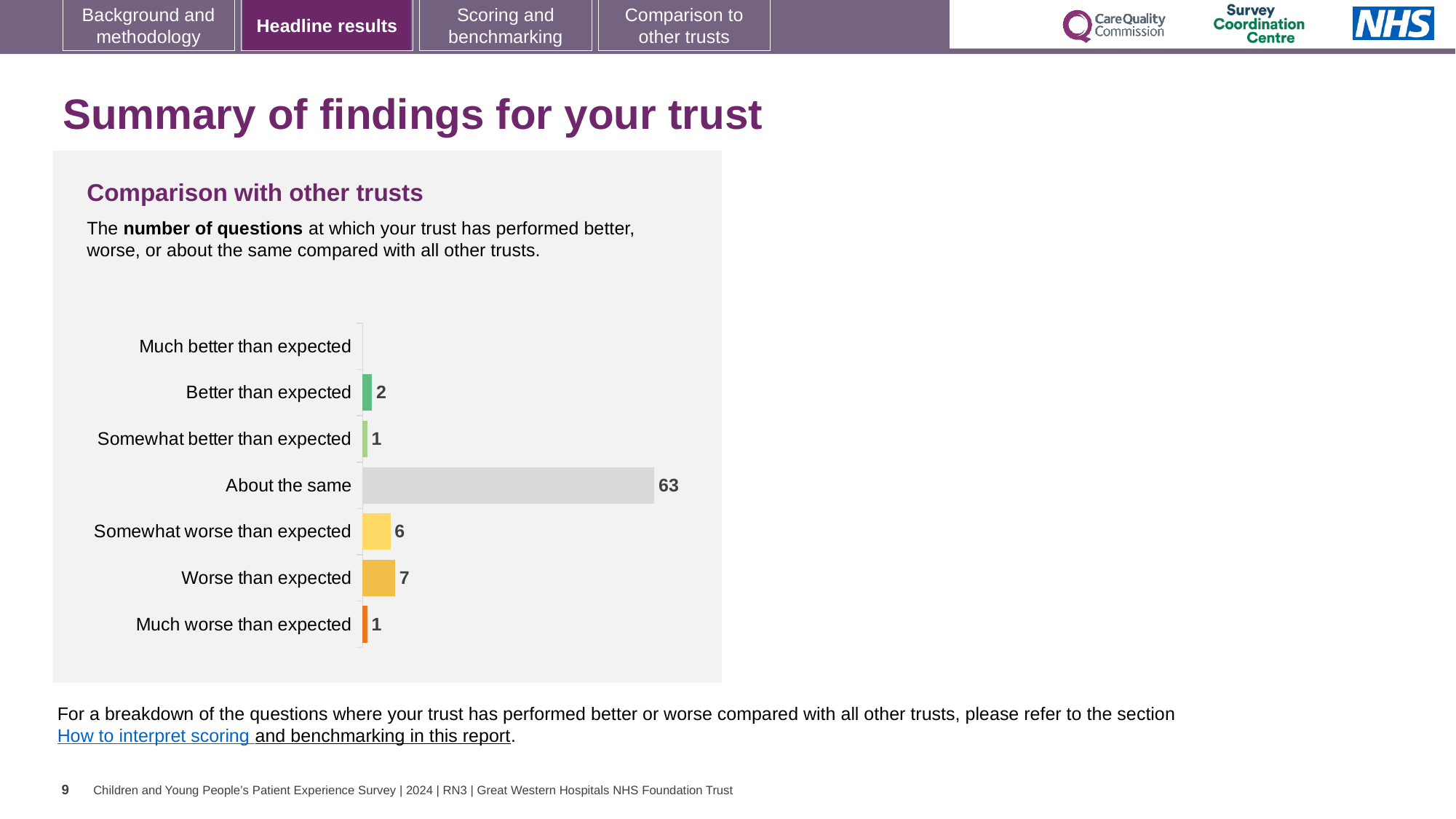
What is the difference between 'About the same' and 'Worse than expected'? 56 What is the difference between 'Worse than expected' and 'Somewhat worse than expected'? 1 What is the value for 'Better than expected'? 2 Which category has the highest number of questions? About the same What is the total number of questions across 'Somewhat better than expected' and 'Much worse than expected'? 2 How many questions were rated 'About the same'? 63 What is the value for 'Worse than expected'? 7 How many categories are shown on the chart? 7 What is the title of the chart section? Comparison with other trusts Which is larger, 'Better than expected' or 'Somewhat worse than expected'? Somewhat worse than expected What kind of chart is shown on the slide? Bar chart What is the value for 'Somewhat worse than expected'? 6